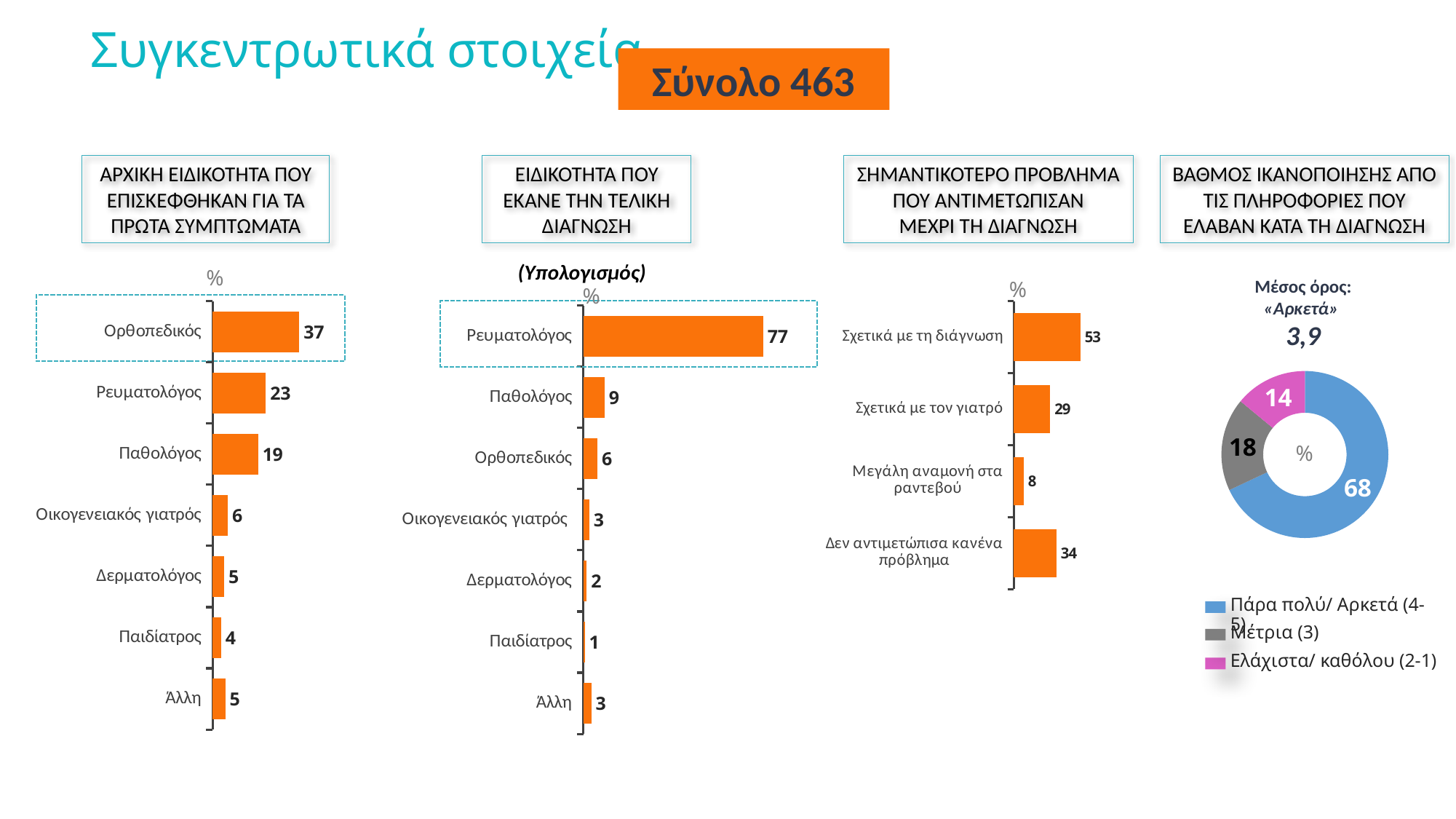
In the chart titled ΣΗΜΑΝΤΙΚΟΤΕΡΟ ΠΡΟΒΛΗΜΑ ΠΟΥ ΑΝΤΙΜΕΤΩΠΙΣΑΝ ΜΕΧΡΙ ΤΗ ΔΙΑΓΝΩΣΗ, what is the value for Σχετικά με τον γιατρό? 29 In the leftmost chart (ΑΡΧΙΚΗ ΕΙΔΙΚΟΤΗΤΑ ΠΟΥ ΕΠΙΣΚΕΦΘΗΚΑΝ ΓΙΑ ΤΑ ΠΡΩΤΑ ΣΥΜΠΤΩΜΑΤΑ), what is the difference between Ρευματολόγος and Παθολόγος? 4 In the leftmost chart (ΑΡΧΙΚΗ ΕΙΔΙΚΟΤΗΤΑ ΠΟΥ ΕΠΙΣΚΕΦΘΗΚΑΝ ΓΙΑ ΤΑ ΠΡΩΤΑ ΣΥΜΠΤΩΜΑΤΑ), how many categories are shown? 7 In the chart titled ΕΙΔΙΚΟΤΗΤΑ ΠΟΥ ΕΚΑΝΕ ΤΗΝ ΤΕΛΙΚΗ ΔΙΑΓΝΩΣΗ, which category has the lowest value? Παιδίατρος In the donut chart on the right (ΒΑΘΜΟΣ ΙΚΑΝΟΠΟΙΗΣΗΣ ΑΠΟ ΤΙΣ ΠΛΗΡΟΦΟΡΙΕΣ ΠΟΥ ΕΛΑΒΑΝ ΚΑΤΑ ΤΗ ΔΙΑΓΝΩΣΗ), what is the value for Μέτρια (3)? 18 In the chart titled ΕΙΔΙΚΟΤΗΤΑ ΠΟΥ ΕΚΑΝΕ ΤΗΝ ΤΕΛΙΚΗ ΔΙΑΓΝΩΣΗ, which category has the highest value? Ρευματολόγος In the chart titled ΕΙΔΙΚΟΤΗΤΑ ΠΟΥ ΕΚΑΝΕ ΤΗΝ ΤΕΛΙΚΗ ΔΙΑΓΝΩΣΗ, what is the value for Παθολόγος? 9 In the donut chart on the right (ΒΑΘΜΟΣ ΙΚΑΝΟΠΟΙΗΣΗΣ ΑΠΟ ΤΙΣ ΠΛΗΡΟΦΟΡΙΕΣ ΠΟΥ ΕΛΑΒΑΝ ΚΑΤΑ ΤΗ ΔΙΑΓΝΩΣΗ), how many entries does the legend list? 3 In the leftmost chart (ΑΡΧΙΚΗ ΕΙΔΙΚΟΤΗΤΑ ΠΟΥ ΕΠΙΣΚΕΦΘΗΚΑΝ ΓΙΑ ΤΑ ΠΡΩΤΑ ΣΥΜΠΤΩΜΑΤΑ), what is the value for Ορθοπεδικός? 37 In the chart titled ΣΗΜΑΝΤΙΚΟΤΕΡΟ ΠΡΟΒΛΗΜΑ ΠΟΥ ΑΝΤΙΜΕΤΩΠΙΣΑΝ ΜΕΧΡΙ ΤΗ ΔΙΑΓΝΩΣΗ, which is larger: Σχετικά με τη διάγνωση or Δεν αντιμετώπισα κανένα πρόβλημα? Σχετικά με τη διάγνωση In the chart titled ΣΗΜΑΝΤΙΚΟΤΕΡΟ ΠΡΟΒΛΗΜΑ ΠΟΥ ΑΝΤΙΜΕΤΩΠΙΣΑΝ ΜΕΧΡΙ ΤΗ ΔΙΑΓΝΩΣΗ, which category has the lowest value? Μεγάλη αναμονή στα ραντεβού In the chart titled ΕΙΔΙΚΟΤΗΤΑ ΠΟΥ ΕΚΑΝΕ ΤΗΝ ΤΕΛΙΚΗ ΔΙΑΓΝΩΣΗ, what kind of chart is used? Bar chart